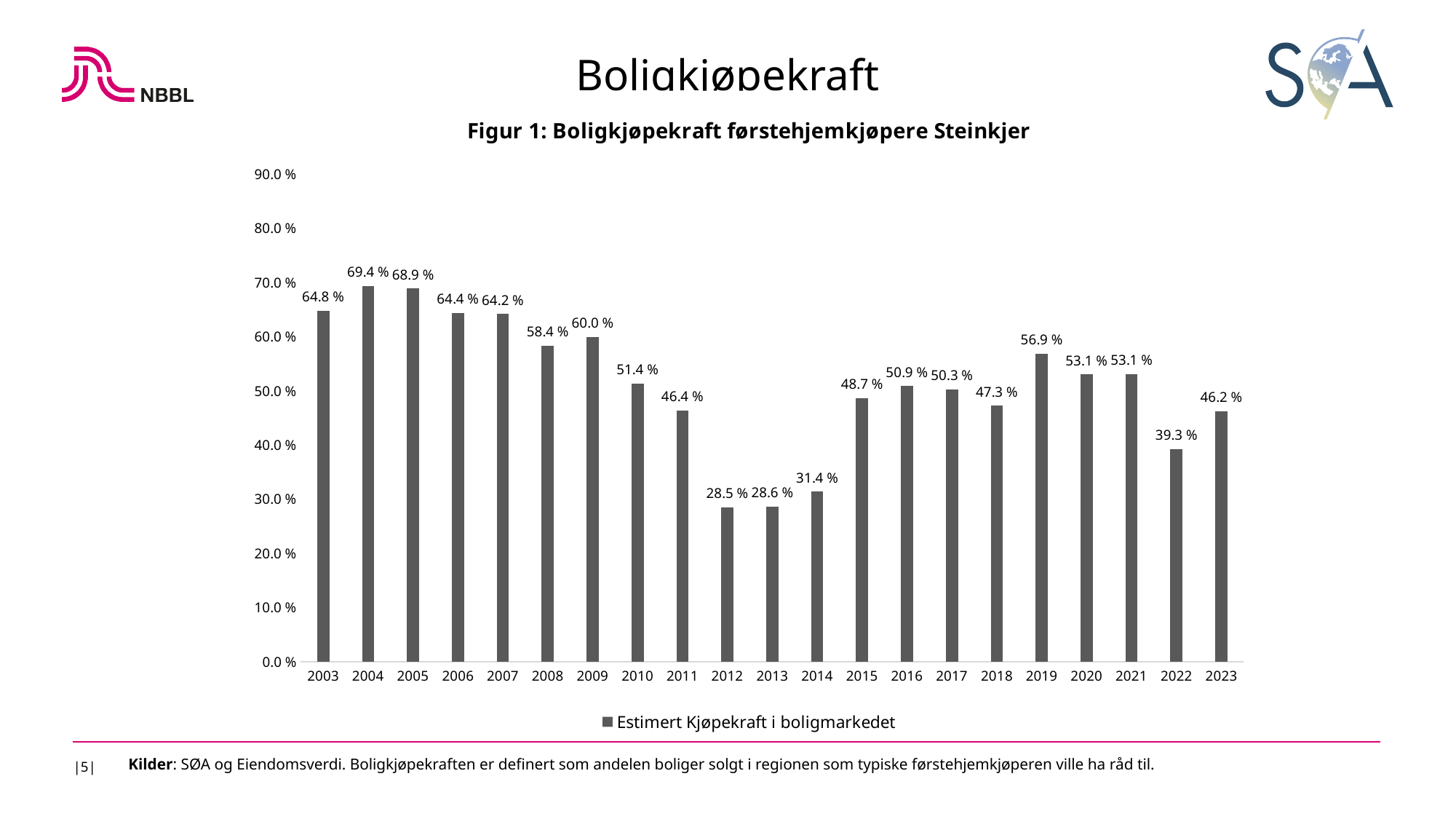
What is the value for 2012 in Figur 1? 28.5 % What is the difference between the values for 2023 and 2022 in Figur 1? 6.9 % How many series does the legend of Figur 1 list? 1 How many years are shown on the x axis of Figur 1? 21 What is the value for 2023 in Figur 1? 46.2 % What type of chart is shown in Figur 1? Bar chart Which year has the larger value in Figur 1, 2010 or 2016? 2010 What is the legend entry in Figur 1? Estimert Kjøpekraft i boligmarkedet Which year has the lowest value in Figur 1? 2012 Which year has the highest value in Figur 1? 2004 What is the difference between the values for 2004 and 2023 in Figur 1? 23.2 % What is the value for 2019 in Figur 1? 56.9 %